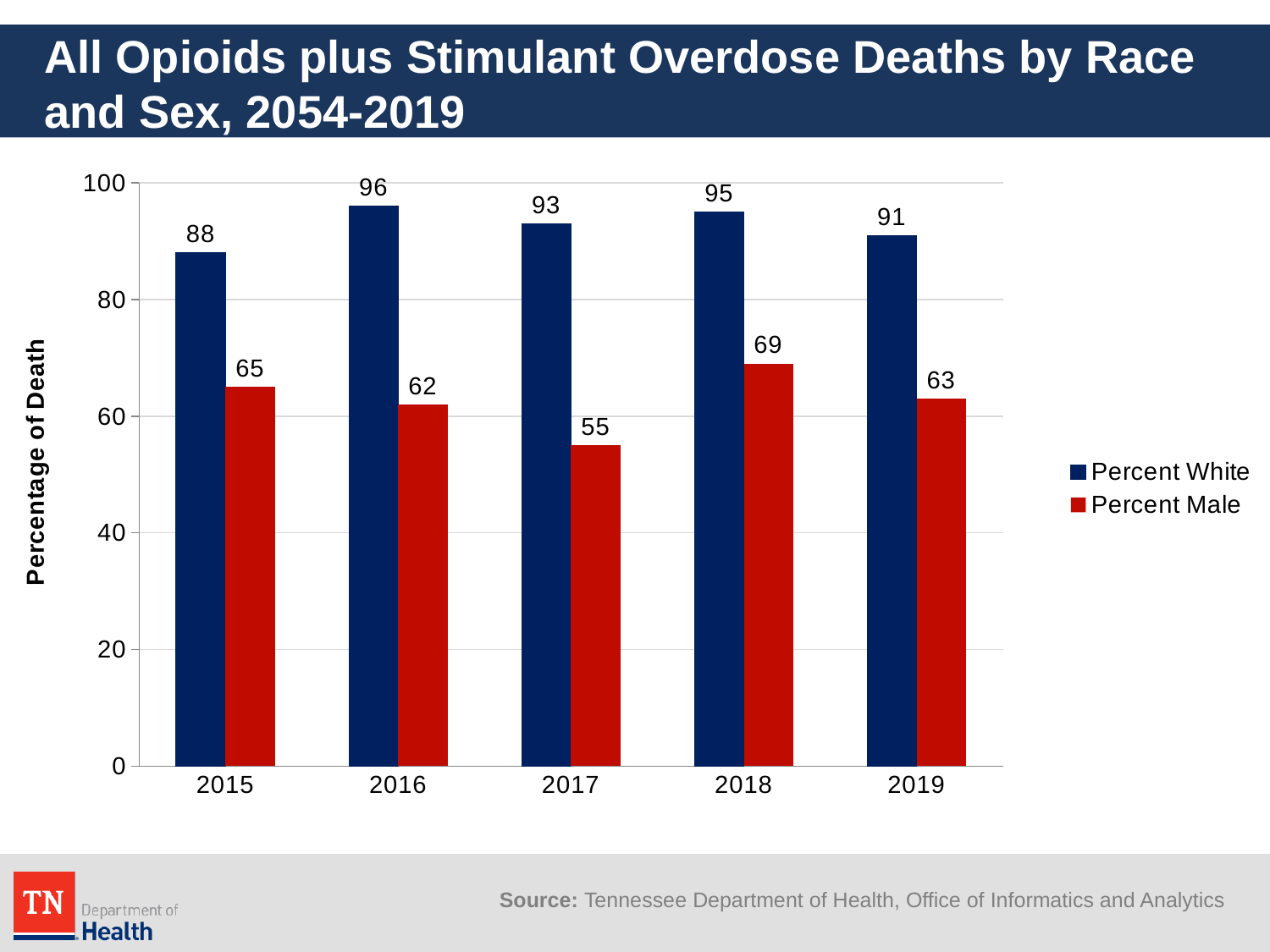
How many years are shown on the x axis? 5 What kind of chart is shown on the slide? bar chart What is the Percent White value for 2016? 96 What is the Percent Male value for 2019? 63 What is the difference between Percent White and Percent Male in 2018? 26 Which year has the highest Percent White value? 2016 Is the Percent White value for 2019 greater or less than 80? greater Is the Percent Male value for 2015 larger or smaller than the Percent Male value for 2016? larger What is the label of the y axis? Percentage of Death Which year has the lowest Percent Male value? 2017 How many series does the legend list? 2 What is the Percent Male value for 2017? 55